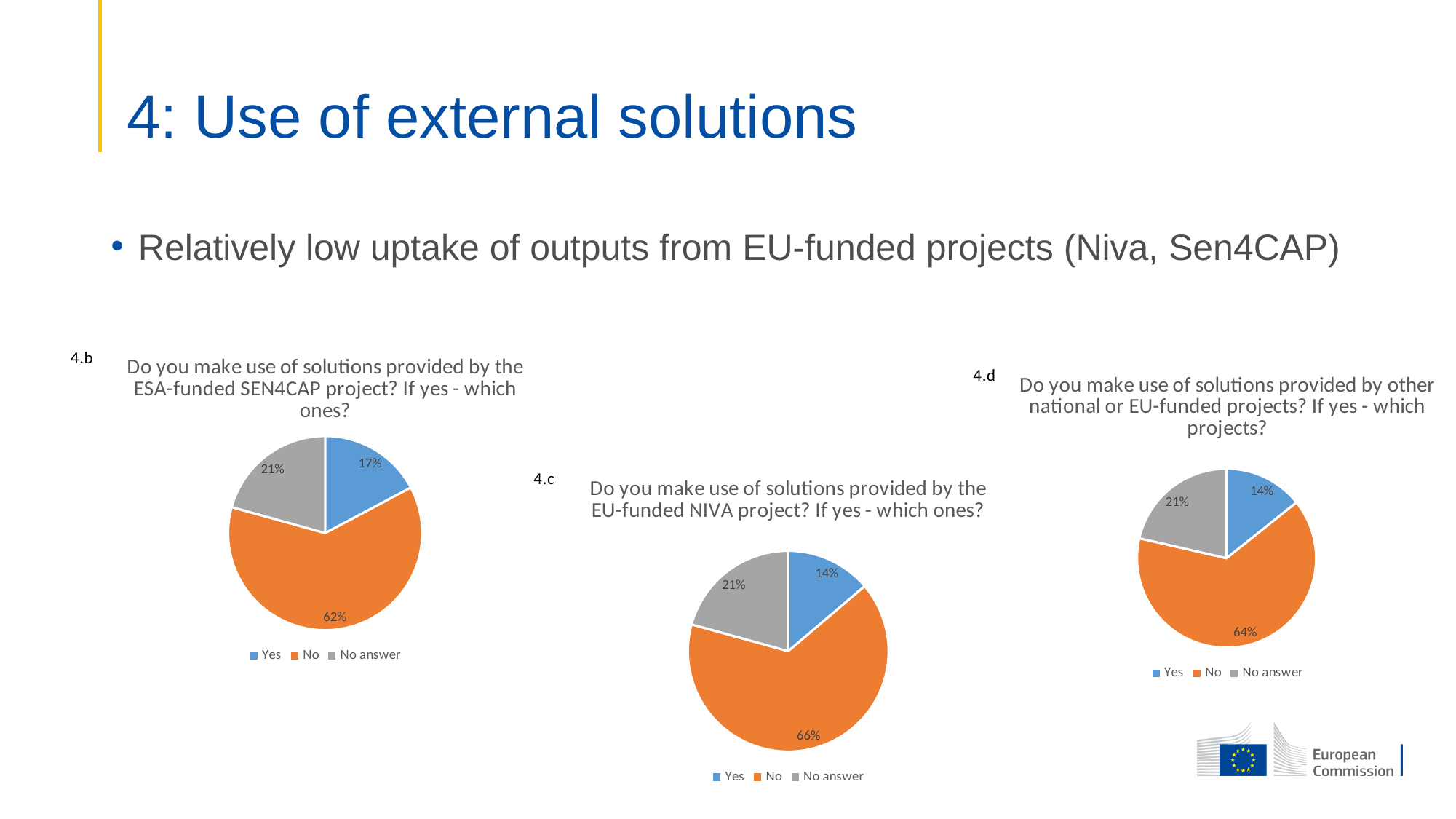
In the pie chart about other national or EU-funded projects (4.d), what share of respondents answered No? 64% In the NIVA pie chart (4.c), what share of respondents answered Yes? 14% In the SEN4CAP pie chart (4.b), what share of respondents answered Yes? 17% In the NIVA pie chart (4.c), is the share for No answer larger or smaller than the share for Yes? larger In the SEN4CAP pie chart (4.b), what is the difference between the No share and the Yes share? 45% What type of chart is used for the NIVA question (4.c)? pie chart In the pie chart about other national or EU-funded projects (4.d), what share gave No answer? 21% In the SEN4CAP pie chart (4.b), what share of respondents answered No? 62% How many series does the legend of the pie chart about other national or EU-funded projects (4.d) list? 3 In the SEN4CAP pie chart (4.b), which category has the largest share? No In the NIVA pie chart (4.c), what share of respondents answered No? 66% In the NIVA pie chart (4.c), which category has the smallest share? Yes